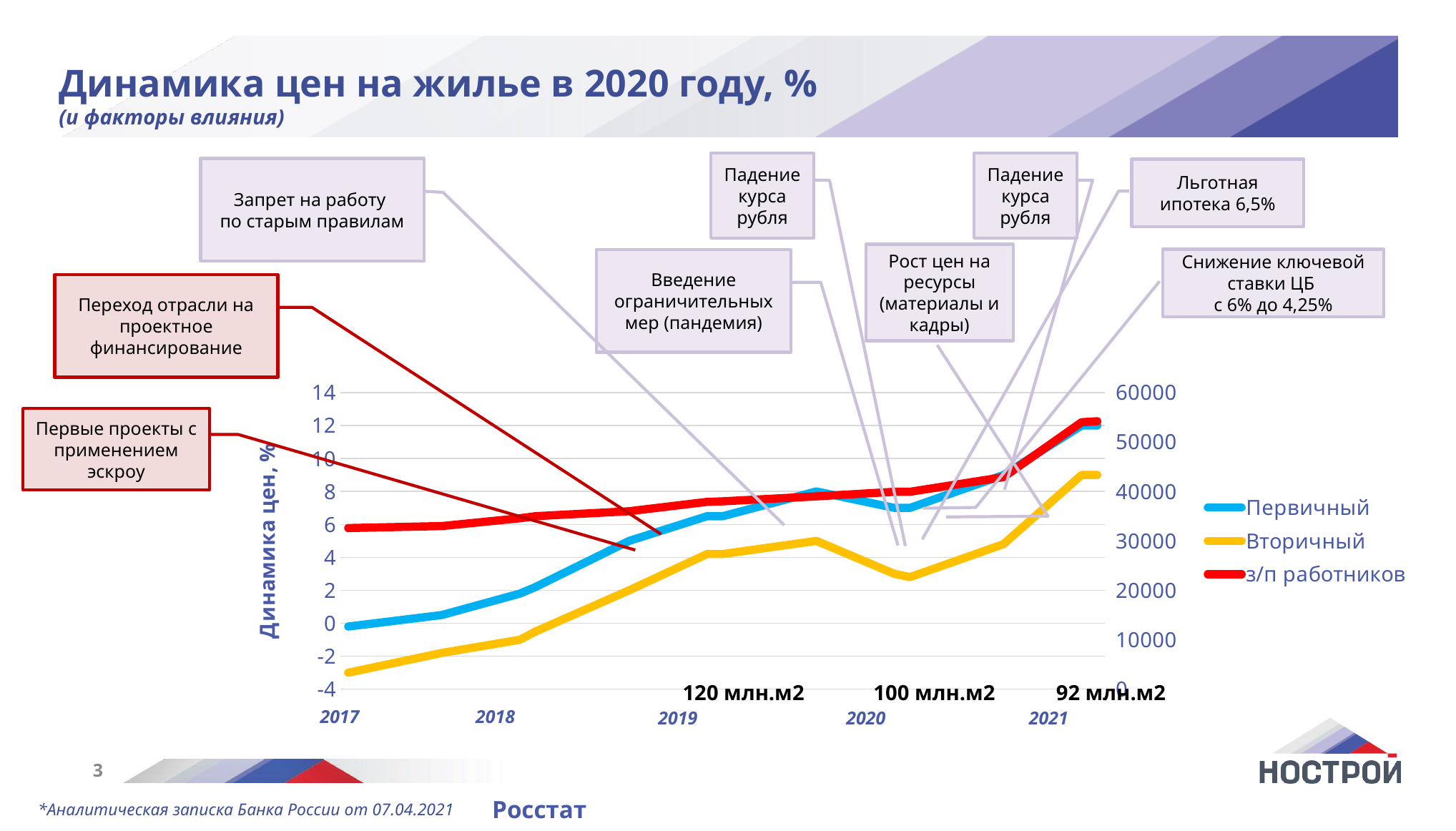
What is the label of the left vertical axis? Динамика цен, % Does the Первичный line rise or fall from 2017 to 2021? rises Is the value for Первичный in 2021 greater or less than 10? greater Does the Вторичный line rise or fall between 2019 and 2020? falls Is the value for Вторичный in 2021 greater or less than 6? greater In 2018, which is higher, Первичный or Вторичный? Первичный How many years are labelled along the x axis? 5 Which series has the lowest value in 2017? Вторичный What kind of chart is shown on the slide? line chart Is the value for Вторичный in 2017 greater or less than 0? less How many series does the legend list? 3 What are the three series named in the legend? Первичный, Вторичный, з/п работников